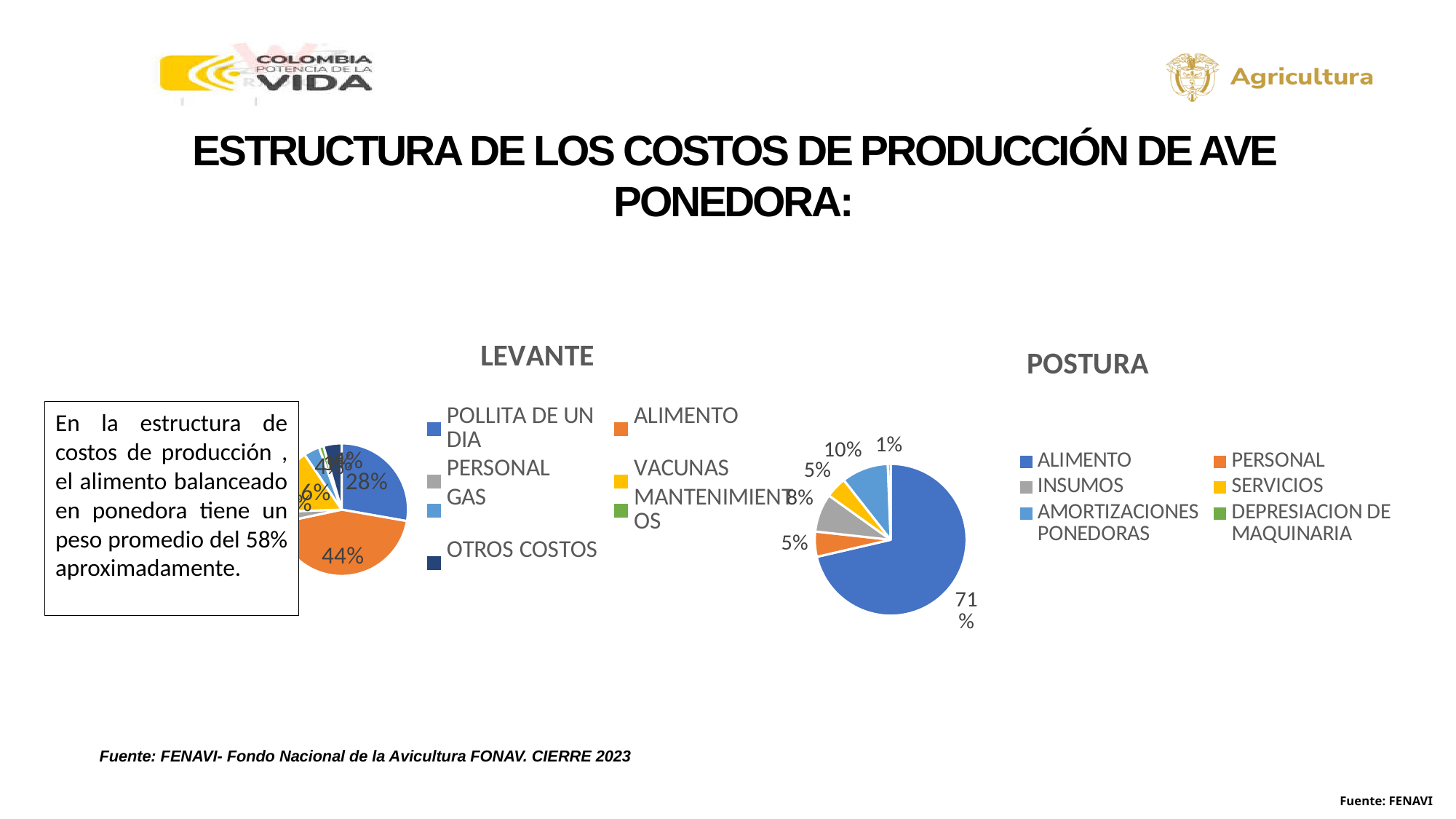
How many categories does the legend of the POSTURA chart list? 6 How many categories does the legend of the LEVANTE chart list? 7 In the LEVANTE chart, what share does POLLITA DE UN DIA have? 28% What kind of chart is the LEVANTE chart? pie chart In the LEVANTE chart, what share does ALIMENTO have? 44% In the POSTURA chart, which is larger: the share for INSUMOS or the share for PERSONAL? INSUMOS In the POSTURA chart, what share does AMORTIZACIONES PONEDORAS have? 10% In the POSTURA chart, which category has the smallest share? DEPRESIACION DE MAQUINARIA In the LEVANTE chart, what is the difference between the ALIMENTO share and the POLLITA DE UN DIA share? 16% In the POSTURA chart, what share does ALIMENTO have? 71% In the POSTURA chart, what share does INSUMOS have? 8% In the LEVANTE chart, which category has the largest share? ALIMENTO